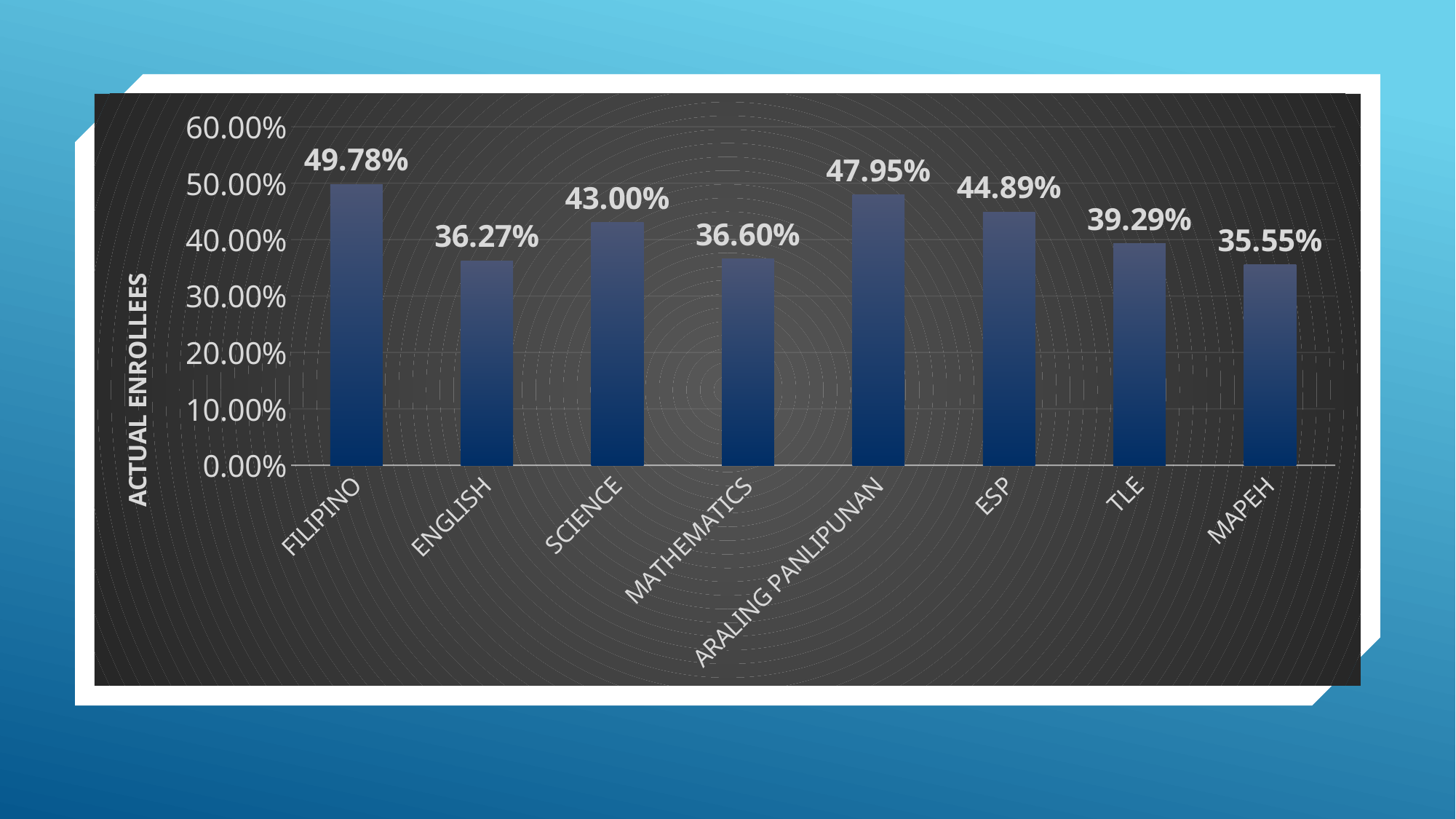
What is the value for ARALING PANLIPUNAN? 47.95% Is the value for ESP greater or less than 40.00%? greater What is the difference between the values for FILIPINO and ENGLISH? 13.51% What is the label of the vertical axis? ACTUAL ENROLLEES Which category has the highest value? FILIPINO How many categories are shown on the x axis? 8 Which category has the lowest value? MAPEH What is the value for FILIPINO? 49.78% Which is larger, the value for SCIENCE or the value for MATHEMATICS? SCIENCE What is the difference between the values for ESP and TLE? 5.60% What kind of chart is shown on the slide? bar chart What is the value for TLE? 39.29%